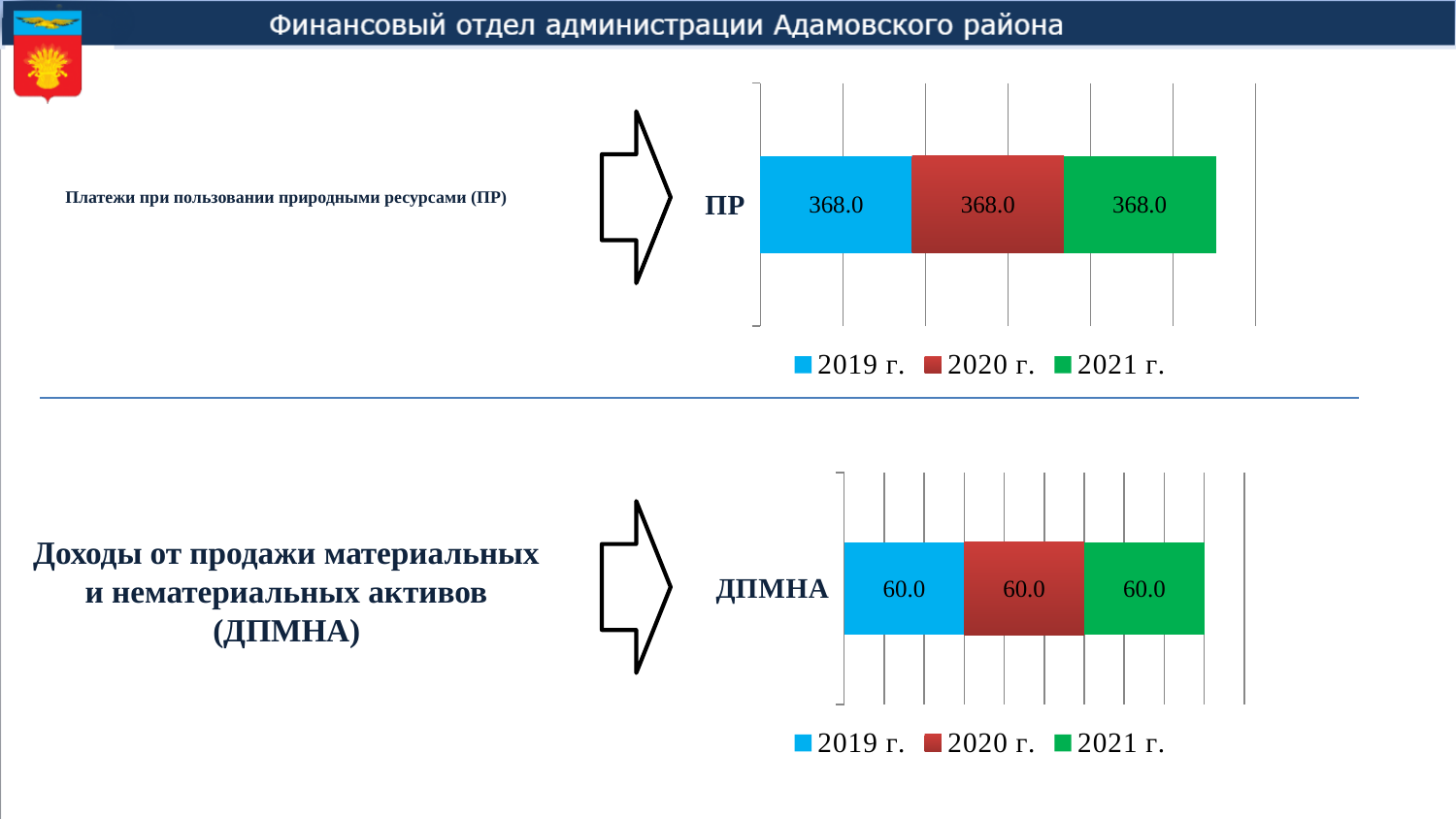
How many categories are shown on the axis of the bottom chart (ДПМНА)? 1 In the bottom chart (ДПМНА), what is the value for 2020 г.? 60.0 What kind of chart is the top chart (ПР)? Stacked bar chart What is the total of the stacked bar in the top chart (ПР)? 1104.0 How many series does the legend of the top chart (ПР) list? 3 In the bottom chart (ДПМНА), what is the value for 2021 г.? 60.0 How many series does the legend of the bottom chart (ДПМНА) list? 3 In the top chart (ПР), what is the value for 2021 г.? 368.0 In the top chart (ПР), what is the difference between the values for 2019 г. and 2020 г.? 0.0 Which years are listed in the legend of the bottom chart (ДПМНА)? 2019 г., 2020 г., 2021 г. What is the total of the stacked bar in the bottom chart (ДПМНА)? 180.0 In the top chart (ПР), what is the value for 2019 г.? 368.0